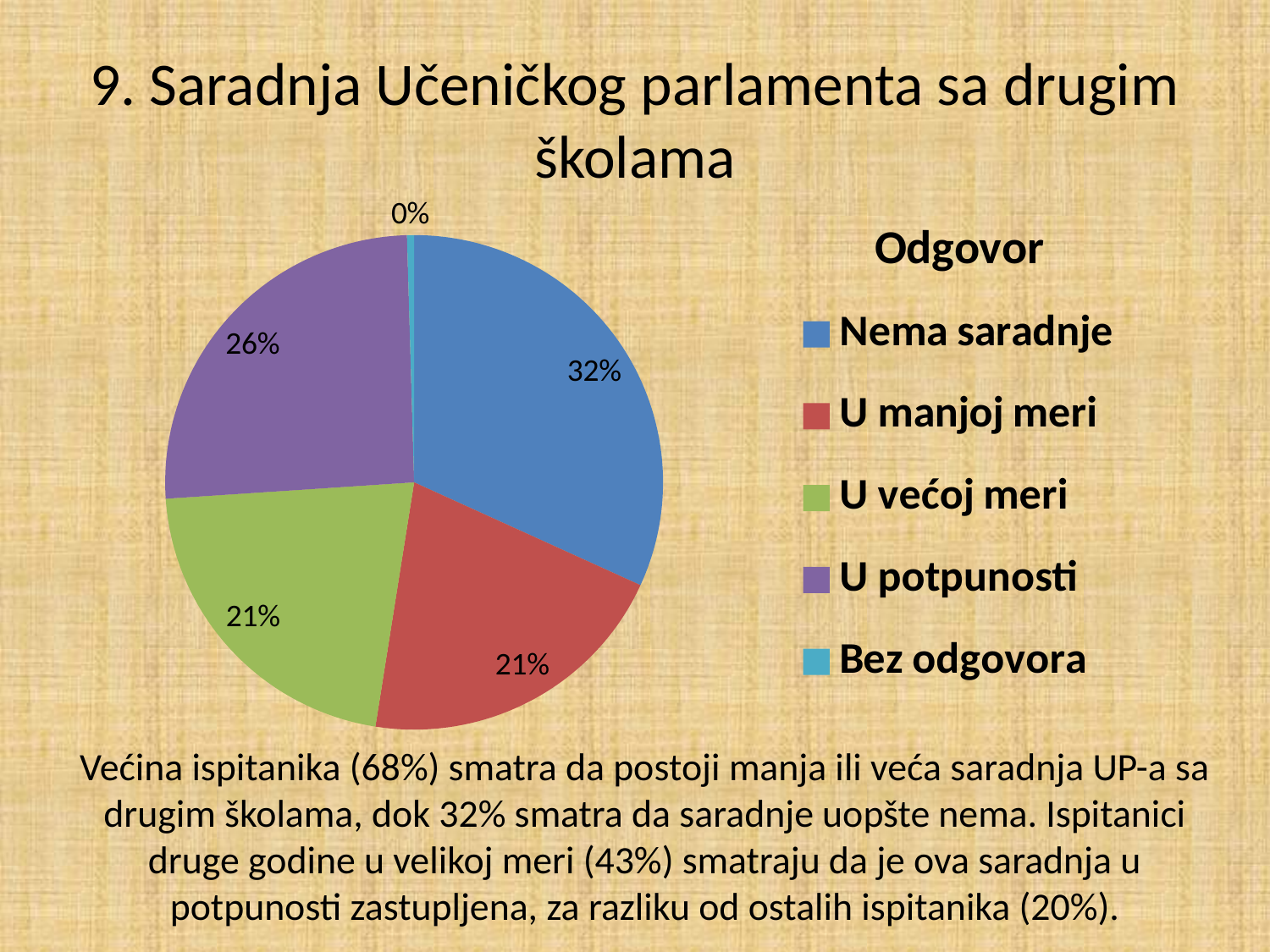
How many categories does the legend list? 5 What share of the pie does "U manjoj meri" take? 21% What share of the pie does "Bez odgovora" take? 0% What share of the pie does "Nema saradnje" take? 32% What is the title of the legend? Odgovor What is the difference in percentage points between "Nema saradnje" and "U potpunosti"? 6 Which is larger, the slice for "U potpunosti" or the slice for "U većoj meri"? U potpunosti Which category has the largest slice of the pie? Nema saradnje What type of chart is shown on the slide? pie chart Which category has the smallest slice of the pie? Bez odgovora What colour is the slice for "U većoj meri"? green